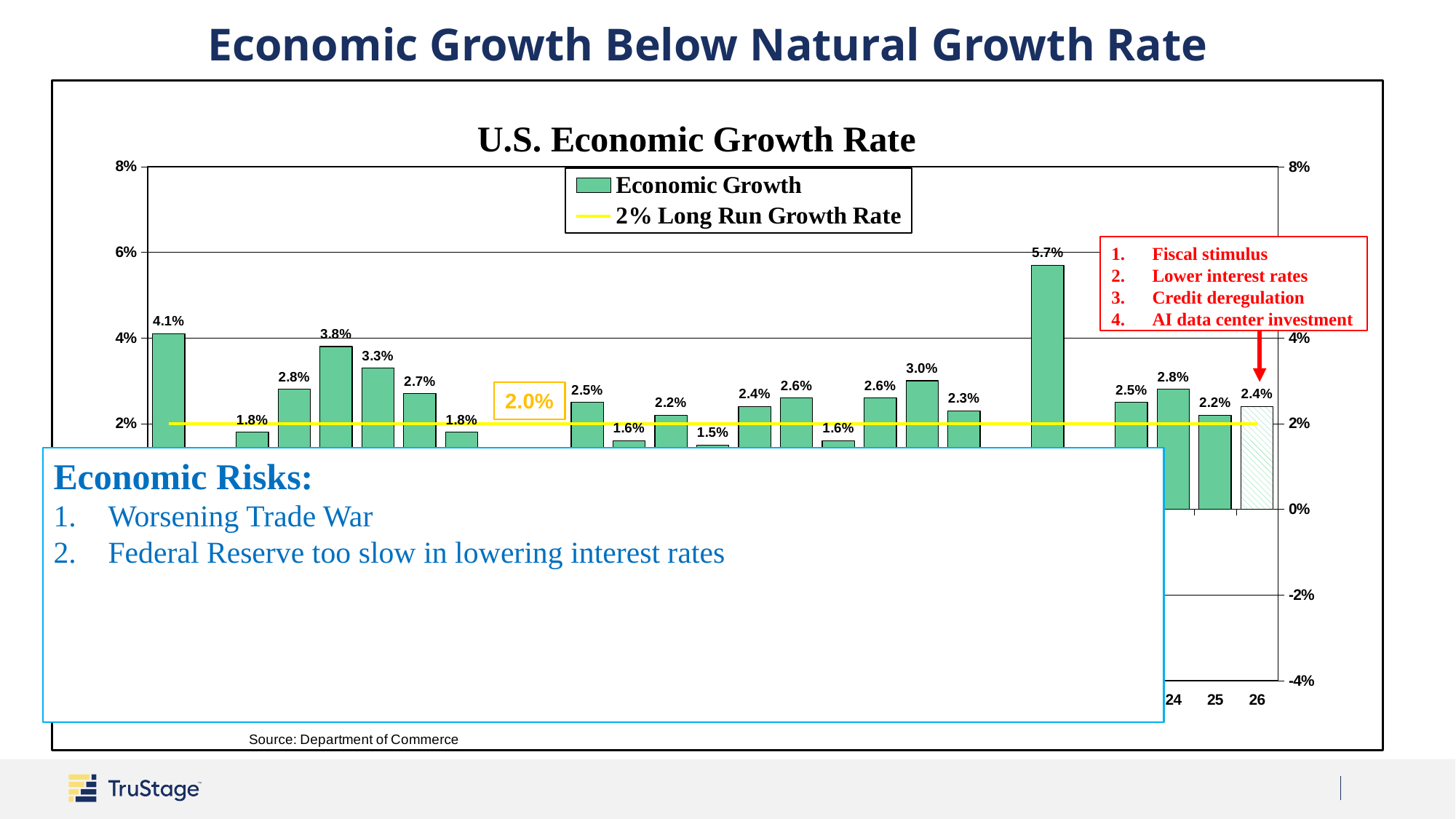
Which year has the higher growth rate, 24 or 25? 24 What is the difference between the growth rates for 26 and 25? 0.2% What value does the yellow horizontal line represent according to the legend? 2% Long Run Growth Rate How many series does the chart legend list? 2 Is the value of the tallest bar greater or less than 4%? greater What is the title of the chart? U.S. Economic Growth Rate What is the economic growth rate shown for 24? 2.8% What is the economic growth rate shown for 26? 2.4% What type of chart is used to show Economic Growth? bar chart What is the economic growth rate shown for 25? 2.2% What is the highest economic growth rate labeled on the chart? 5.7%